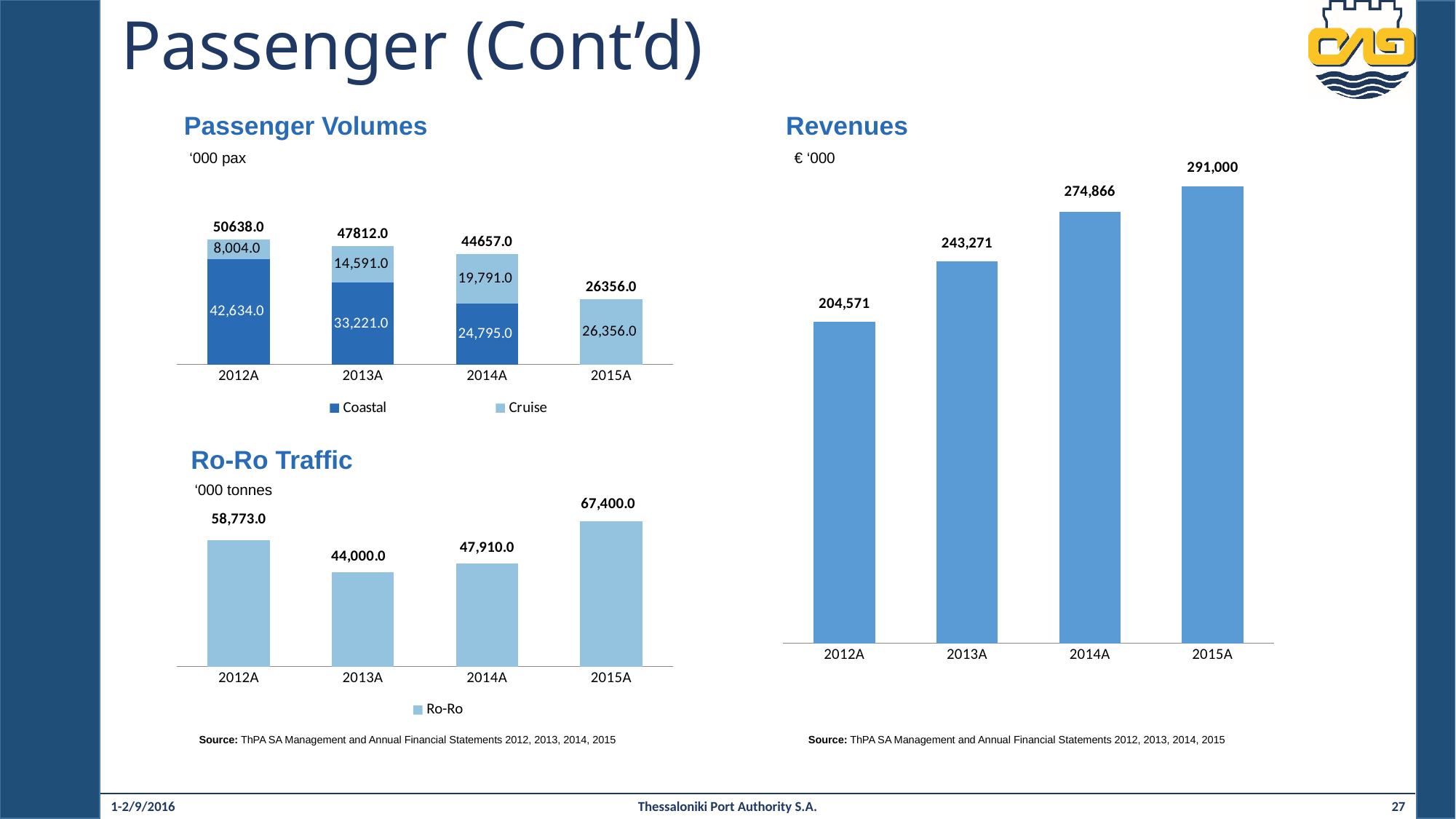
In the Passenger Volumes chart, which year has the lowest total passenger volume? 2015A What kind of chart is the Revenues chart? bar chart In the Passenger Volumes chart, what is the total of the stacked bar for 2013A? 47812.0 In the Ro-Ro Traffic chart, what is the value for 2014A? 47,910.0 In the Passenger Volumes chart, what is the Coastal value for 2012A? 42,634.0 In the Revenues chart, do the values rise or fall from 2012A to 2015A? rise In the Passenger Volumes chart, what is the Cruise value for 2014A? 19,791.0 In the Revenues chart, what is the value for 2013A? 243,271 In the Passenger Volumes chart, how many series does the legend list? 2 In the Ro-Ro Traffic chart, which year has the highest value? 2015A In the Ro-Ro Traffic chart, what is the difference between the 2015A and 2013A values? 23,400.0 In the Revenues chart, what is the difference between the 2015A and 2012A values? 86,429